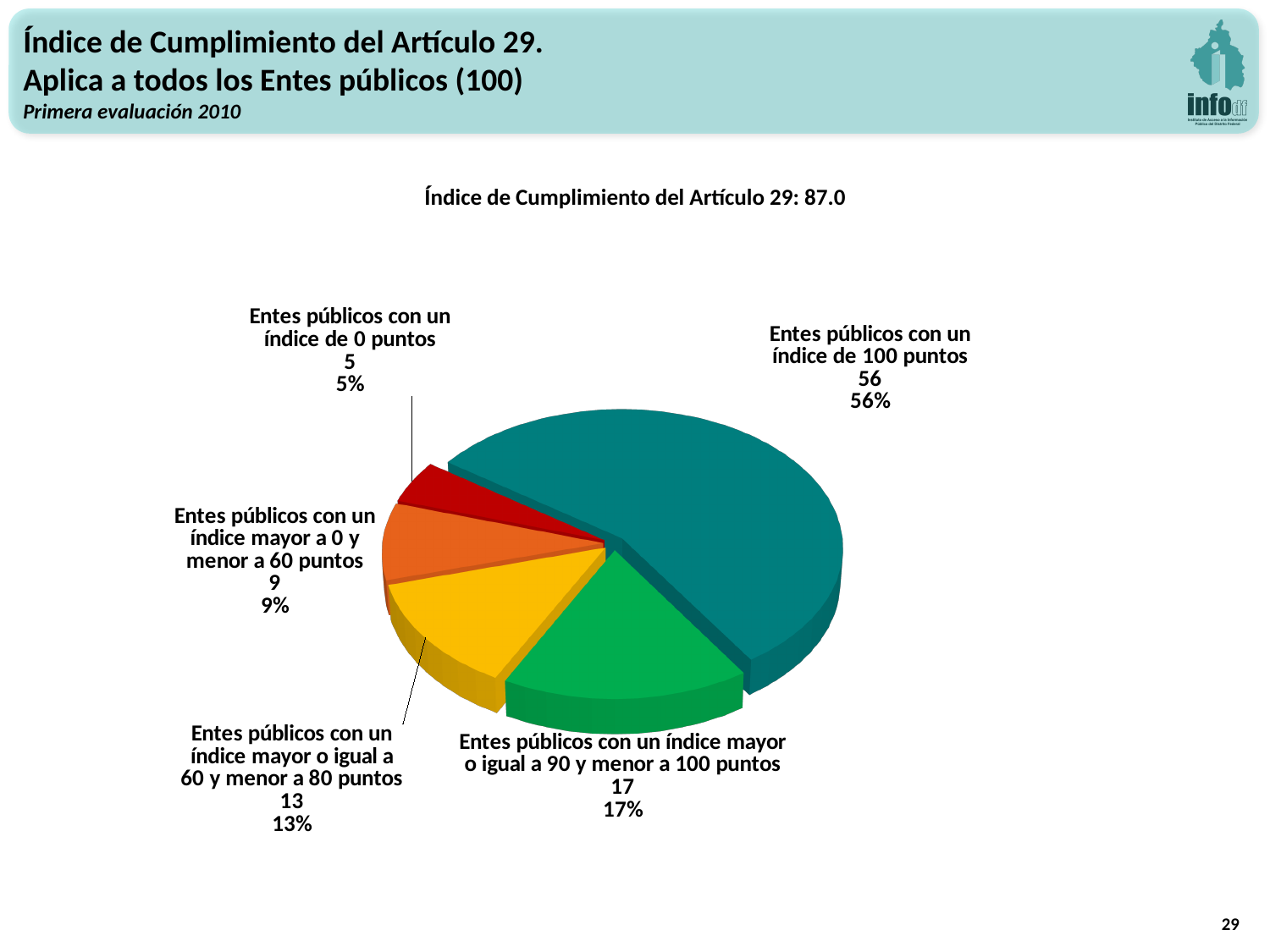
What percentage of public entities have an index greater than or equal to 90 and less than 100 points? 17% What is the difference between the number of public entities with an index of 100 points and those with an index greater than or equal to 90 and less than 100 points? 39 How many public entities have an index of 100 points? 56 What colour is the slice for public entities with an index of 0 points? red How many public entities have an index greater than or equal to 60 and less than 80 points? 13 What kind of chart is shown on the slide? pie chart How many slices does the pie chart have? 5 What share of the pie corresponds to public entities with an index of 0 points? 5% What is the Índice de Cumplimiento del Artículo 29 value stated above the chart? 87.0 Which category has the smallest slice of the pie? Entes públicos con un índice de 0 puntos Which category has the largest slice of the pie? Entes públicos con un índice de 100 puntos Which is larger: the number of public entities with an index greater than 0 and less than 60 points, or those with an index greater than or equal to 60 and less than 80 points? Entes públicos con un índice mayor o igual a 60 y menor a 80 puntos